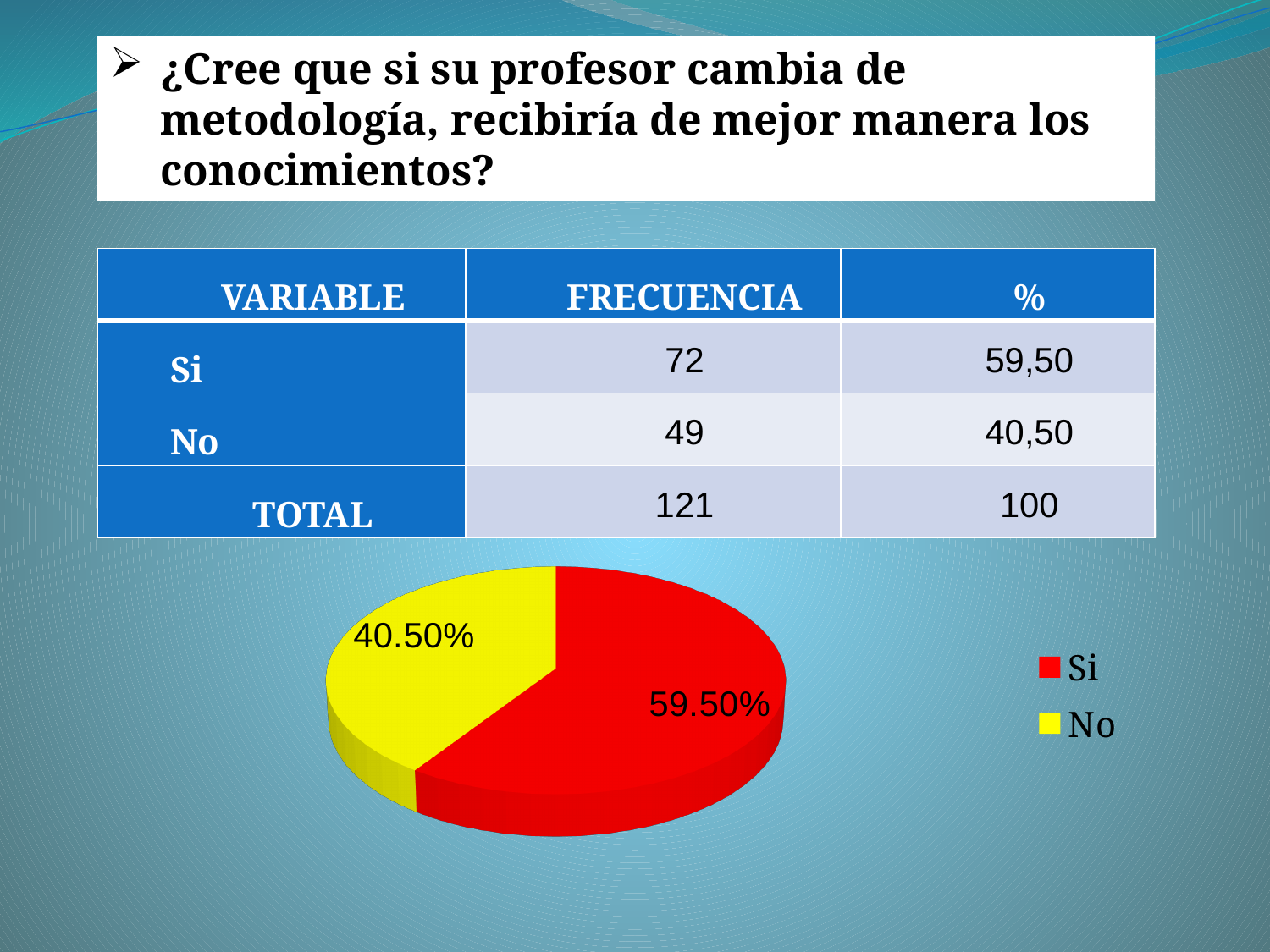
How many slices does the pie chart have? 2 What colour is the "No" slice in the pie chart? yellow Is the share for "Si" greater or less than 50%? greater Which slice is larger, "Si" or "No"? Si What colour is the "Si" slice in the pie chart? red Which slice of the pie is the smallest? No What is the difference in percentage points between the "Si" and "No" slices? 19 percentage points Which slice of the pie is the largest? Si How many entries does the legend list? 2 What kind of chart is shown on the slide? pie chart What share of the pie does the "No" slice represent? 40.50% What share of the pie does the "Si" slice represent? 59.50%